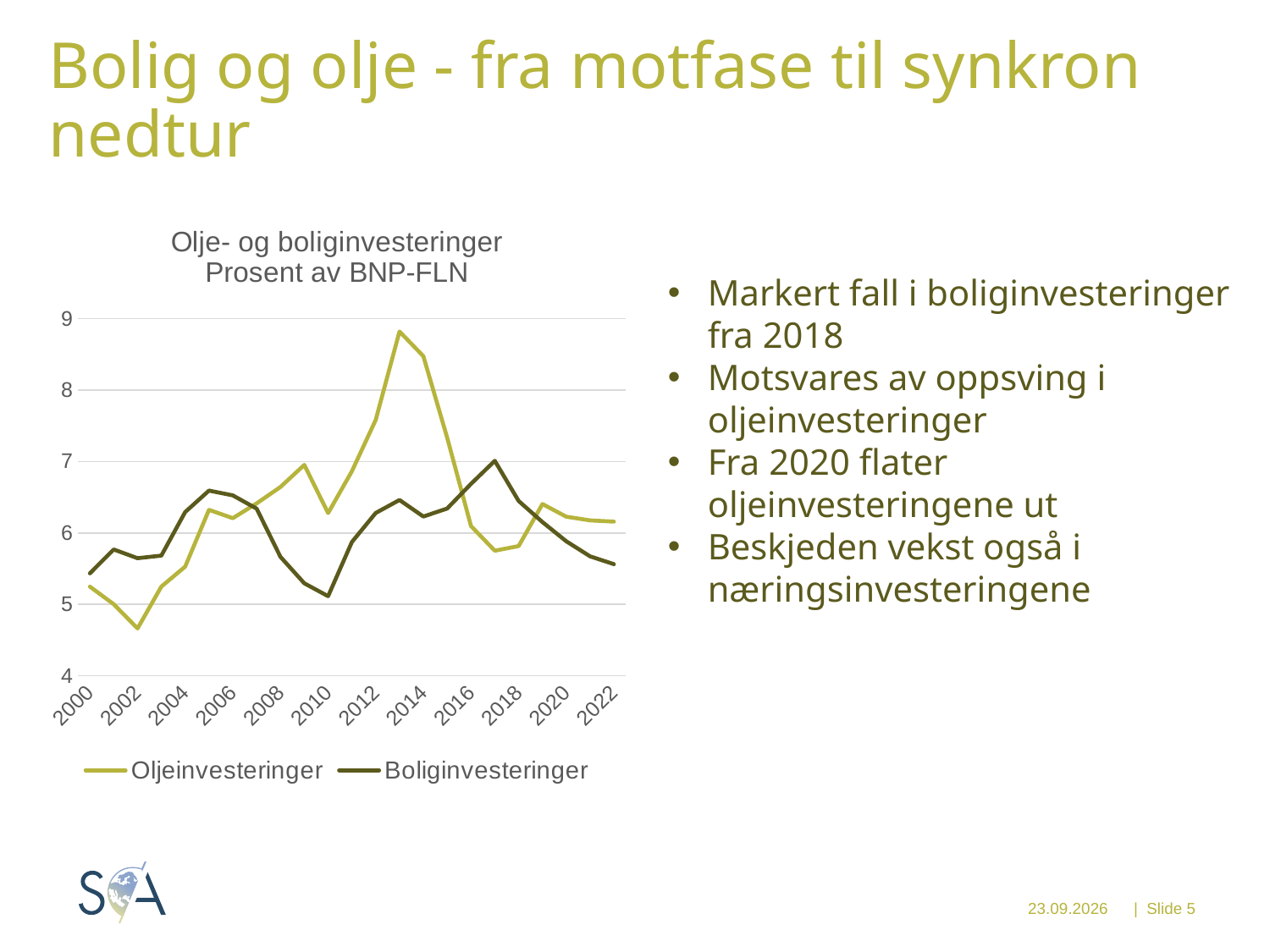
Does the Boliginvesteringer line rise or fall from 2017 to 2022? fall In which year does the Oljeinvesteringer line reach its highest value? 2013 What kind of chart is shown on the slide? line chart Is the value for Oljeinvesteringer in 2013 greater or less than 8? greater In which year does the Oljeinvesteringer line reach its lowest value? 2002 Which series has the higher value in 2013, Oljeinvesteringer or Boliginvesteringer? Oljeinvesteringer Which series has the higher value in 2017, Oljeinvesteringer or Boliginvesteringer? Boliginvesteringer Is the value for Boliginvesteringer in 2010 greater or less than 6? less What are the two series named in the chart legend? Oljeinvesteringer and Boliginvesteringer What is the title of the chart? Olje- og boliginvesteringer Prosent av BNP-FLN How many series does the legend of the chart list? 2 In which year does the Boliginvesteringer line reach its highest value? 2017